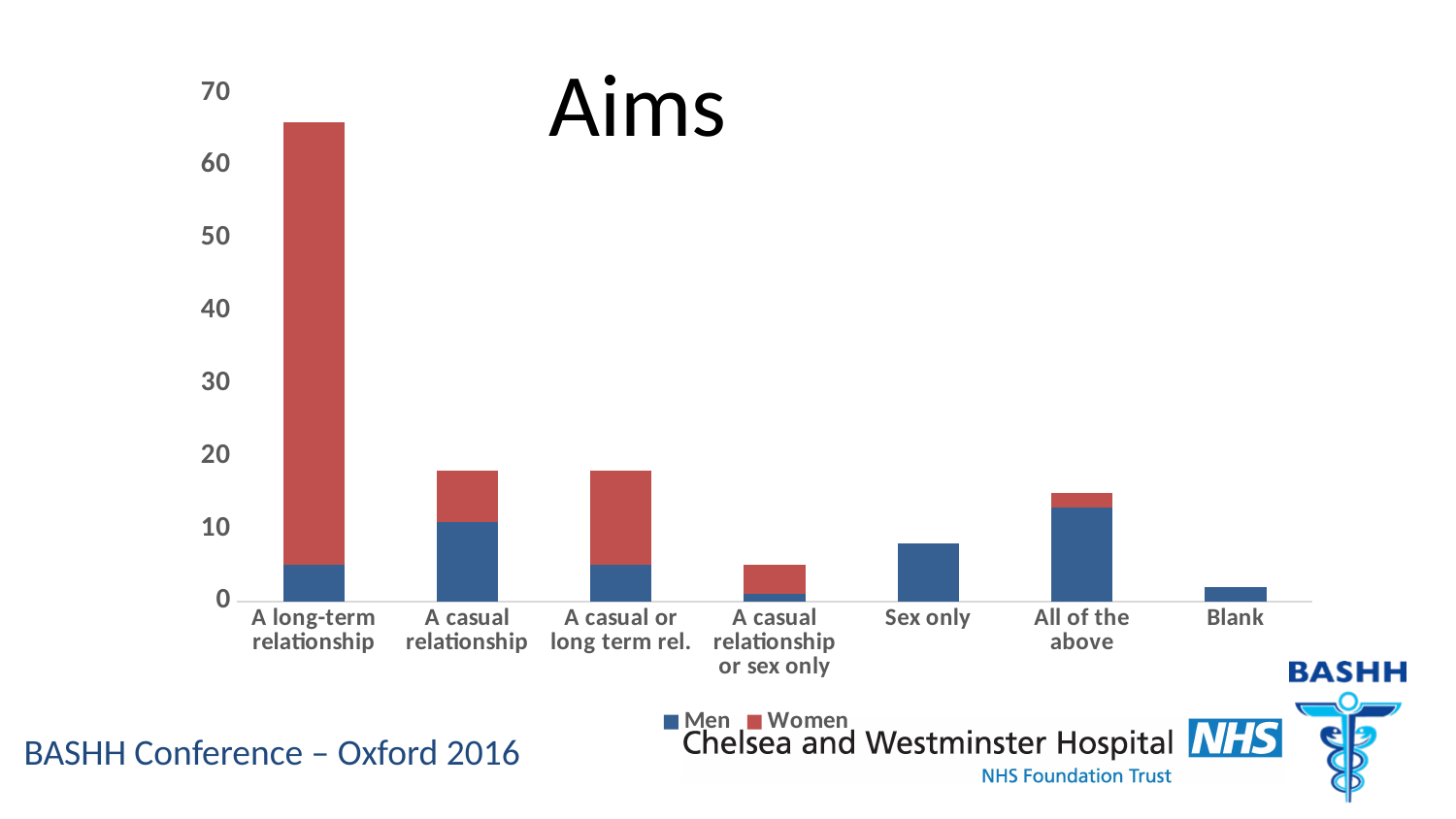
In the 'A long-term relationship' bar, which series has the larger value, Men or Women? Women What kind of chart is shown on the slide? Stacked bar chart How many series does the chart's legend list? 2 Is the total value for 'A long-term relationship' greater or less than 60? greater Is the total value for 'All of the above' greater or less than 10? greater Which category has the shortest stacked bar? Blank Which category has the tallest stacked bar? A long-term relationship Is the total value for 'A casual relationship' greater or less than 20? less Which has the larger total, 'Sex only' or 'Blank'? Sex only Which colour represents Women in the chart's legend? Red How many categories are shown on the x axis of the chart? 7